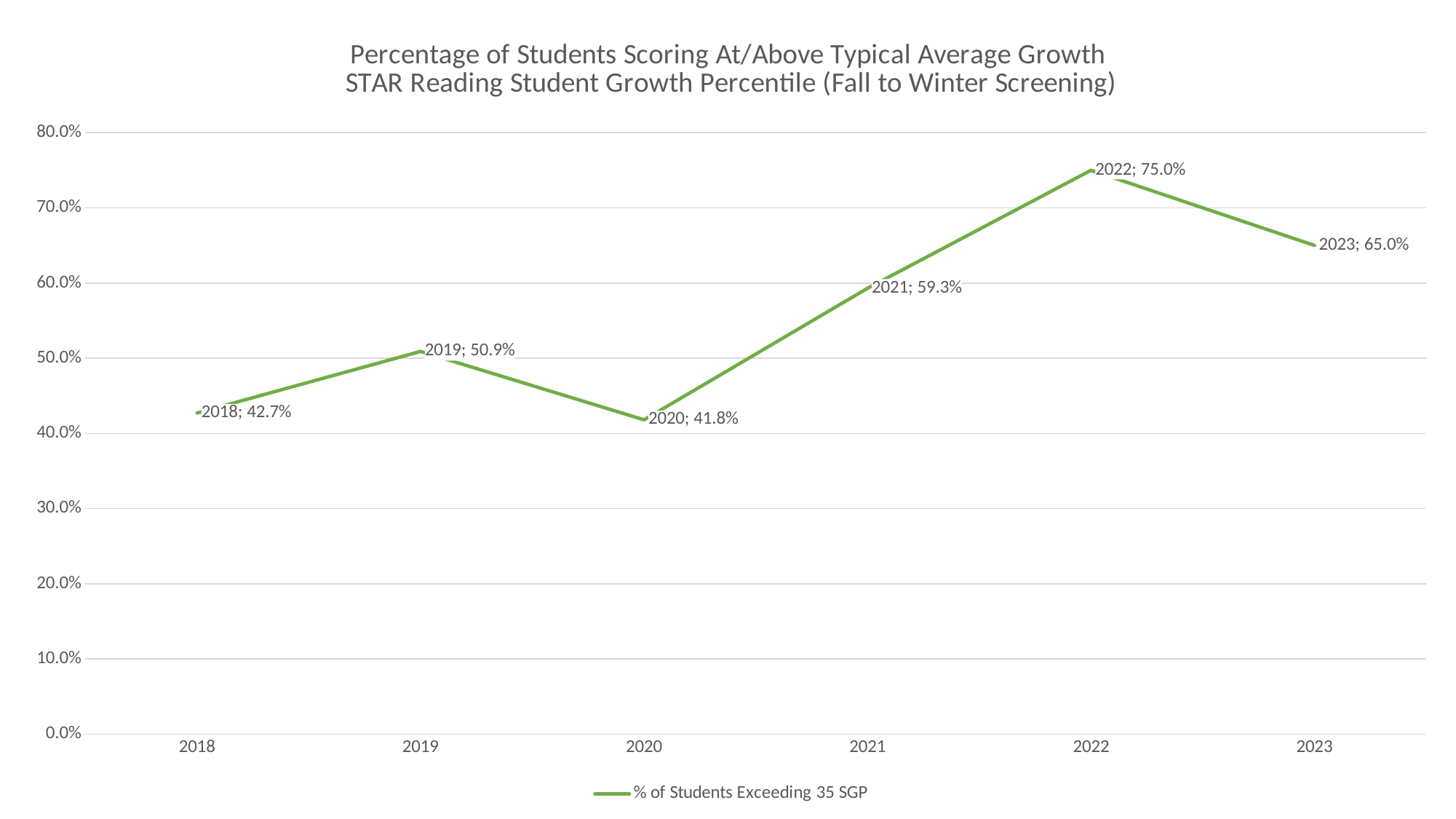
What series name does the legend show? % of Students Exceeding 35 SGP Which year has the highest value? 2022 Which year has the lowest value? 2020 What is the value for 2021? 59.3% How many years are plotted on the chart? 6 What is the difference between the values for 2022 and 2023? 10.0% Is the value for 2022 greater or less than 70.0%? greater What is the difference between the values for 2019 and 2018? 8.2% What kind of chart is this? line chart What is the value for 2023? 65.0% Which is larger, the value for 2019 or the value for 2021? 2021 What is the value for 2018? 42.7%